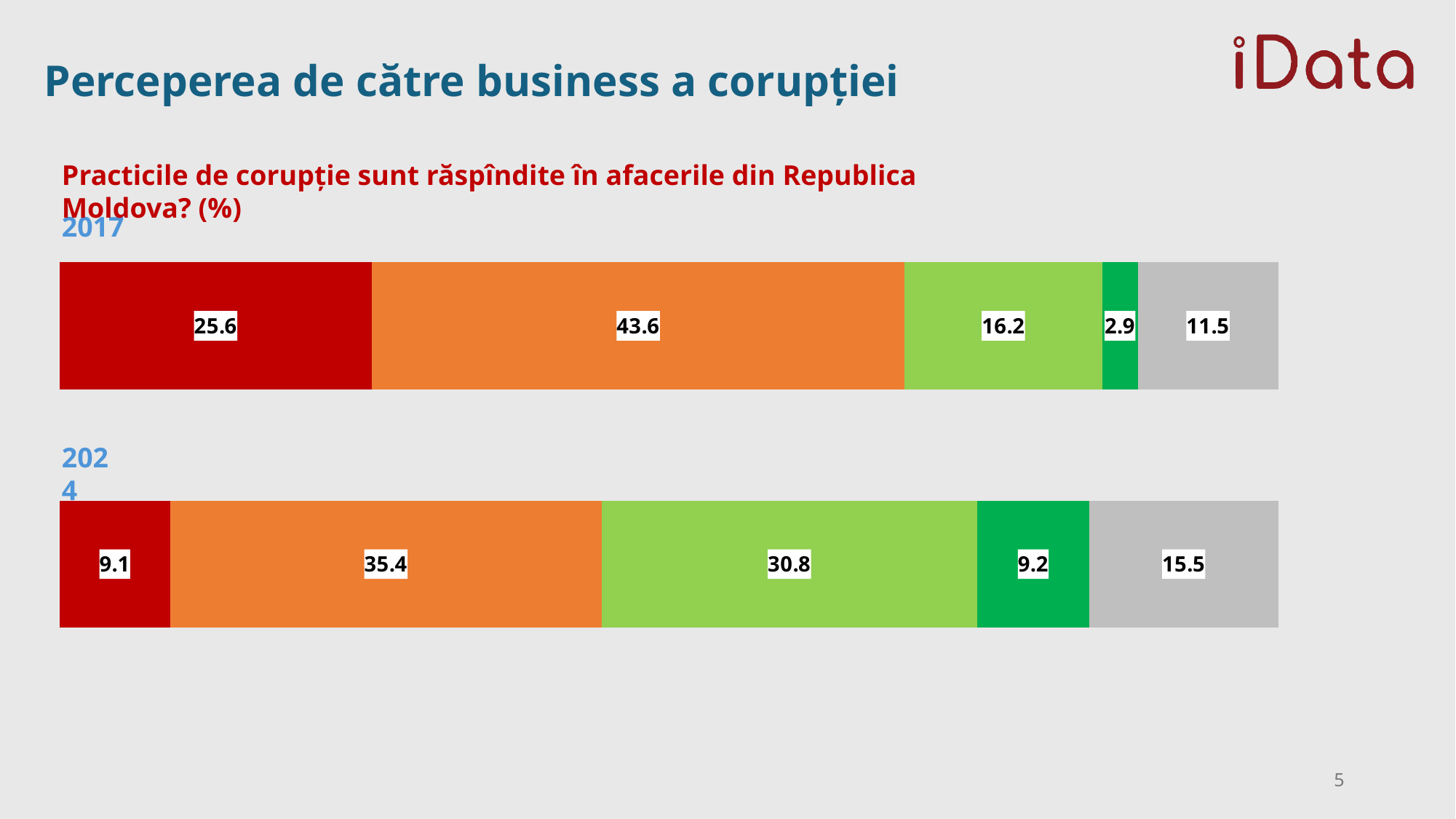
In the 2024 bar, what is the value of the light green segment? 30.8 Which segment has the largest value in the 2017 bar? the orange segment (43.6) How many segments does each stacked bar contain? 5 In the 2017 bar, what is the value of the dark red segment? 25.6 What is the total of the 2024 stacked bar? 100.0 Which segment has the smallest value in the 2017 bar? the green segment (2.9) What kind of chart is shown on the slide? stacked bar chart Which segment has the largest value in the 2024 bar? the orange segment (35.4) In the 2017 bar, what is the value of the orange segment? 43.6 In the 2024 bar, what is the value of the grey segment? 15.5 Is the orange segment larger in 2017 or in 2024? 2017 What is the difference between the dark red segment in 2017 and the dark red segment in 2024? 16.5